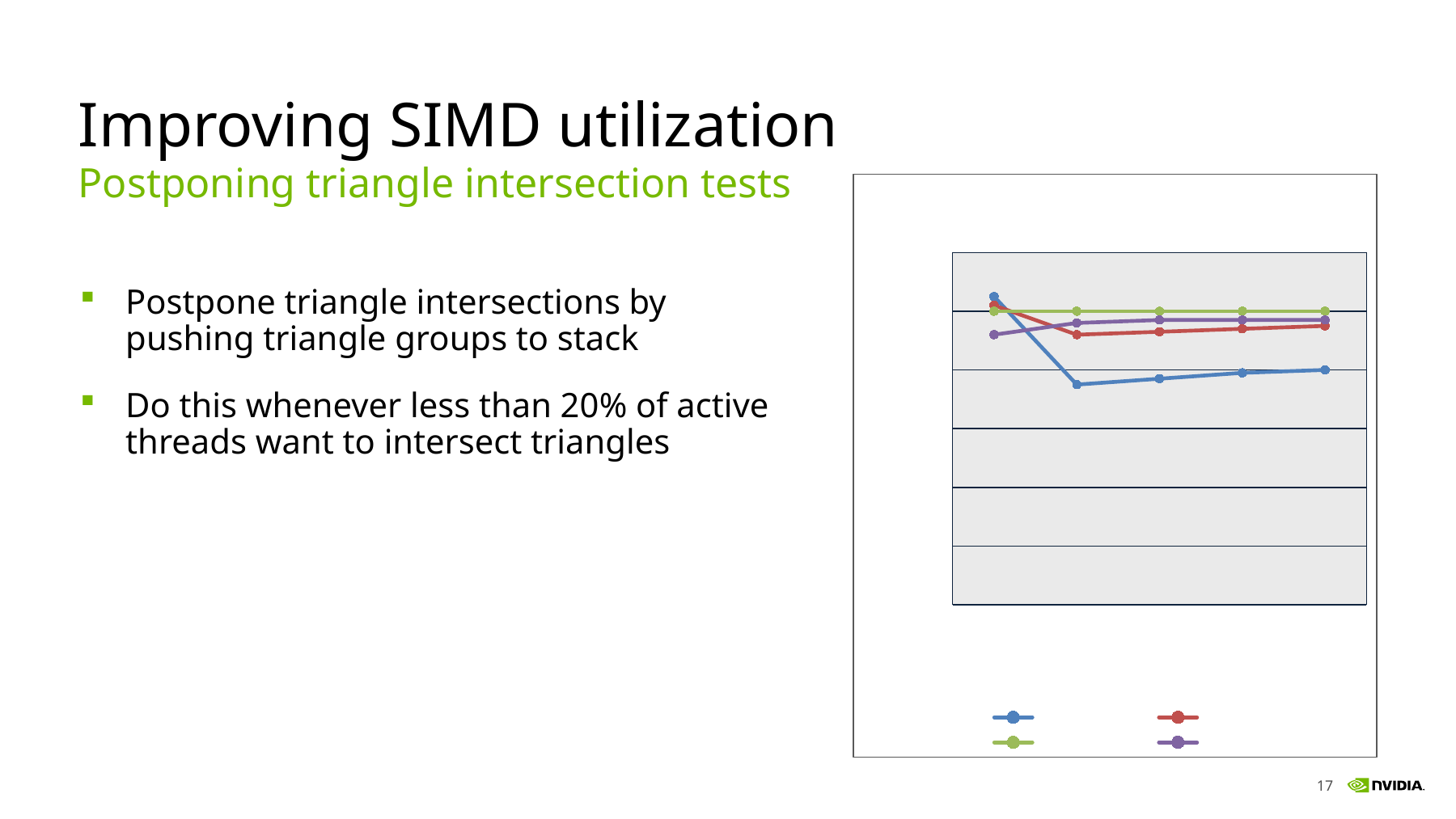
How many series does the chart's legend list? 4 How many data points does each line in the chart have? 5 At the right-hand end of the chart, is the green line above or below the red line? above What colours are the four lines in the chart? blue, red, green, purple Which coloured line is the highest at the right-hand end of the chart? green Which coloured line stays essentially flat across all its points? green What kind of chart is shown on the right side of the slide? line chart Which coloured line is the highest at the first (left-most) point? blue Which coloured line is the lowest at the first (left-most) point? purple Which coloured line is the lowest at the right-hand end of the chart? blue Does the blue line rise or fall between its first and second points? fall